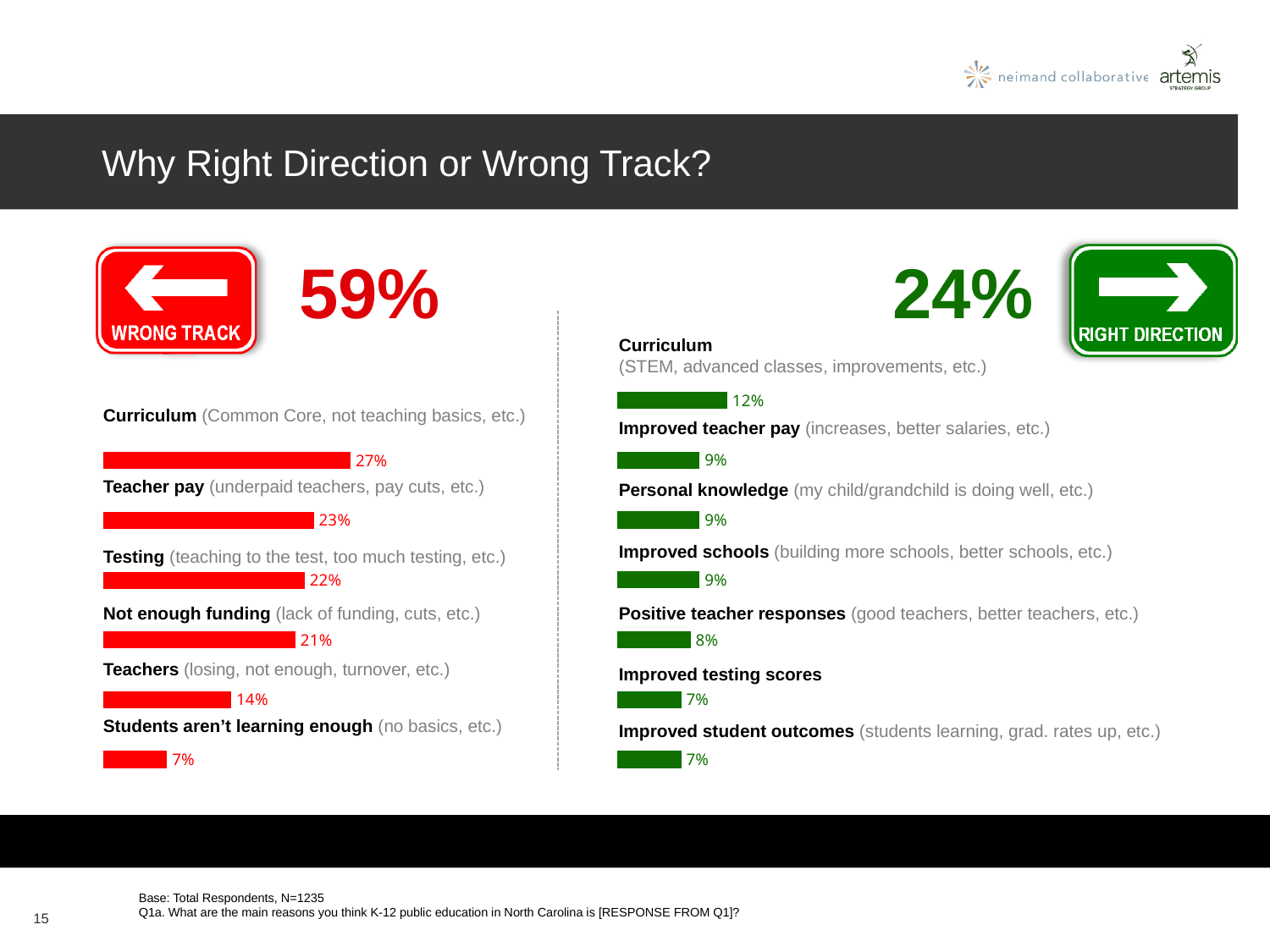
In the Right Direction chart on the right, which reason has the highest percentage? Curriculum In the Wrong Track chart on the left, which reason has the lowest percentage? Students aren't learning enough In the Wrong Track chart on the left, which reason has the highest percentage? Curriculum In the Wrong Track chart on the left, what percentage is shown for Teacher pay? 23% In the Wrong Track chart on the left, which is larger: Testing or Not enough funding? Testing In the Right Direction chart on the right, what percentage is shown for Positive teacher responses? 8% How many reasons are listed in the Wrong Track chart on the left? 6 In the Wrong Track chart on the left, what percentage is shown for Curriculum? 27% How many reasons are listed in the Right Direction chart on the right? 7 In the Wrong Track chart on the left, what is the difference between the percentages for Curriculum and Teachers? 13% In the Right Direction chart on the right, what percentage is shown for Curriculum? 12% What type of chart is used on the slide to show the reasons? Bar chart